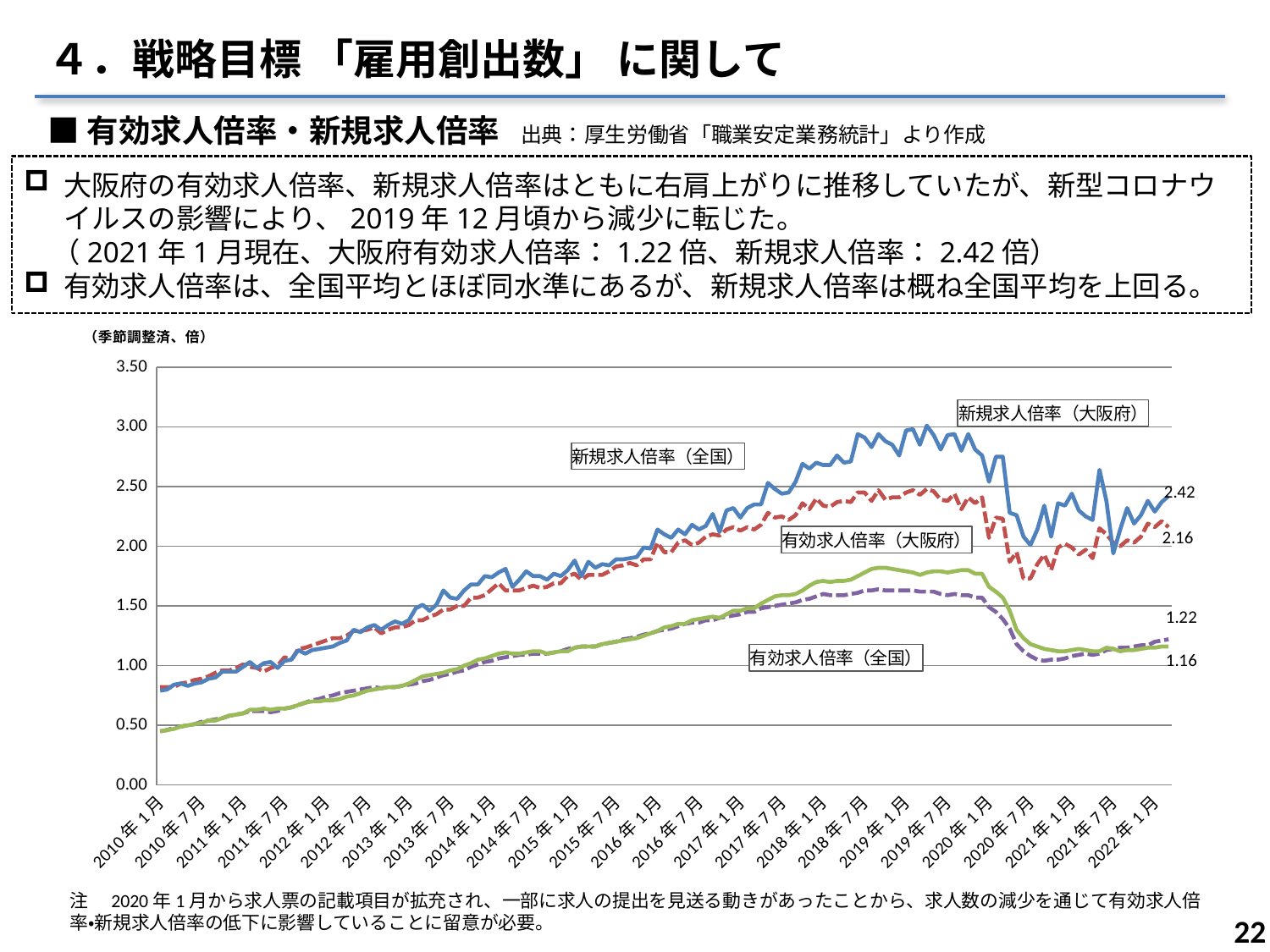
What is the final labelled value of 新規求人倍率（全国）? 2.16 Is the value of 新規求人倍率（大阪府） at 2010年1月 greater or less than 1.00? less What is the final labelled value of 新規求人倍率（大阪府）? 2.42 What is the final labelled value of 有効求人倍率（大阪府）? 1.16 What is the difference between the final labelled values of 新規求人倍率（大阪府） and 新規求人倍率（全国）? 0.26 Which series has the highest final labelled value? 新規求人倍率（大阪府） What kind of chart is shown on the slide? line chart What is the final labelled value of 有効求人倍率（全国）? 1.22 What is the difference between the final labelled values of 有効求人倍率（大阪府） and 有効求人倍率（全国）? 0.06 What unit label is shown above the vertical axis of the chart? （季節調整済、倍） How many lines (series) are plotted on the chart? 4 Which series has the lowest final labelled value? 有効求人倍率（大阪府）